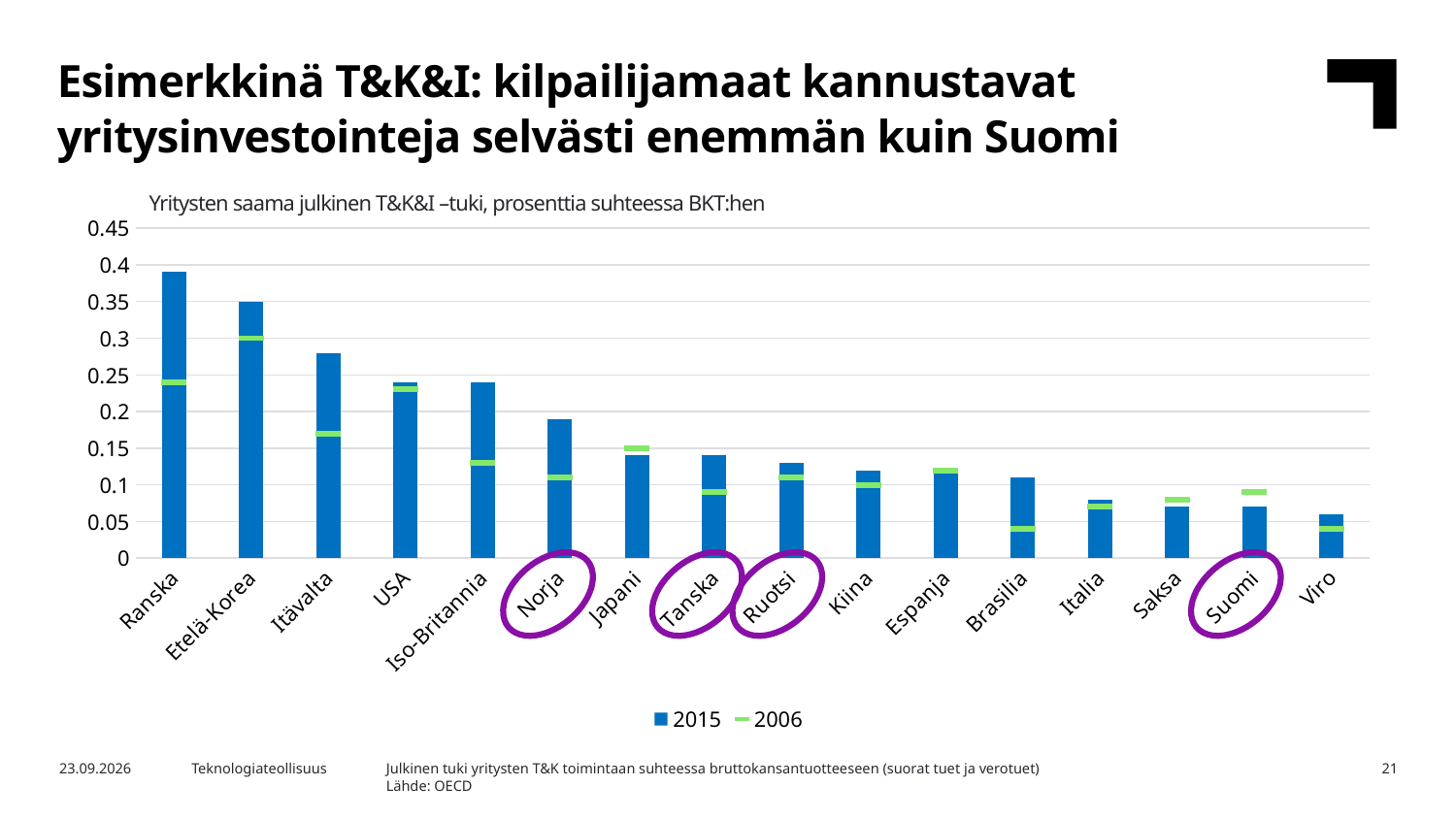
Is the 2015 value for Itävalta greater or less than 0.25? greater Do the 2015 values generally rise or fall from left to right along the x axis? fall How many countries are shown on the x axis of the chart? 16 Which has the larger 2015 value, Ranska or Suomi? Ranska Is the 2015 value for Norja greater or less than 0.15? greater What kind of chart is shown on the slide? bar chart Which country has the lowest 2015 value in the chart? Viro Is the 2015 value for Ranska greater or less than 0.35? greater Which country has the highest 2015 value in the chart? Ranska Which two years are listed in the chart legend? 2015 and 2006 How many series does the chart legend list? 2